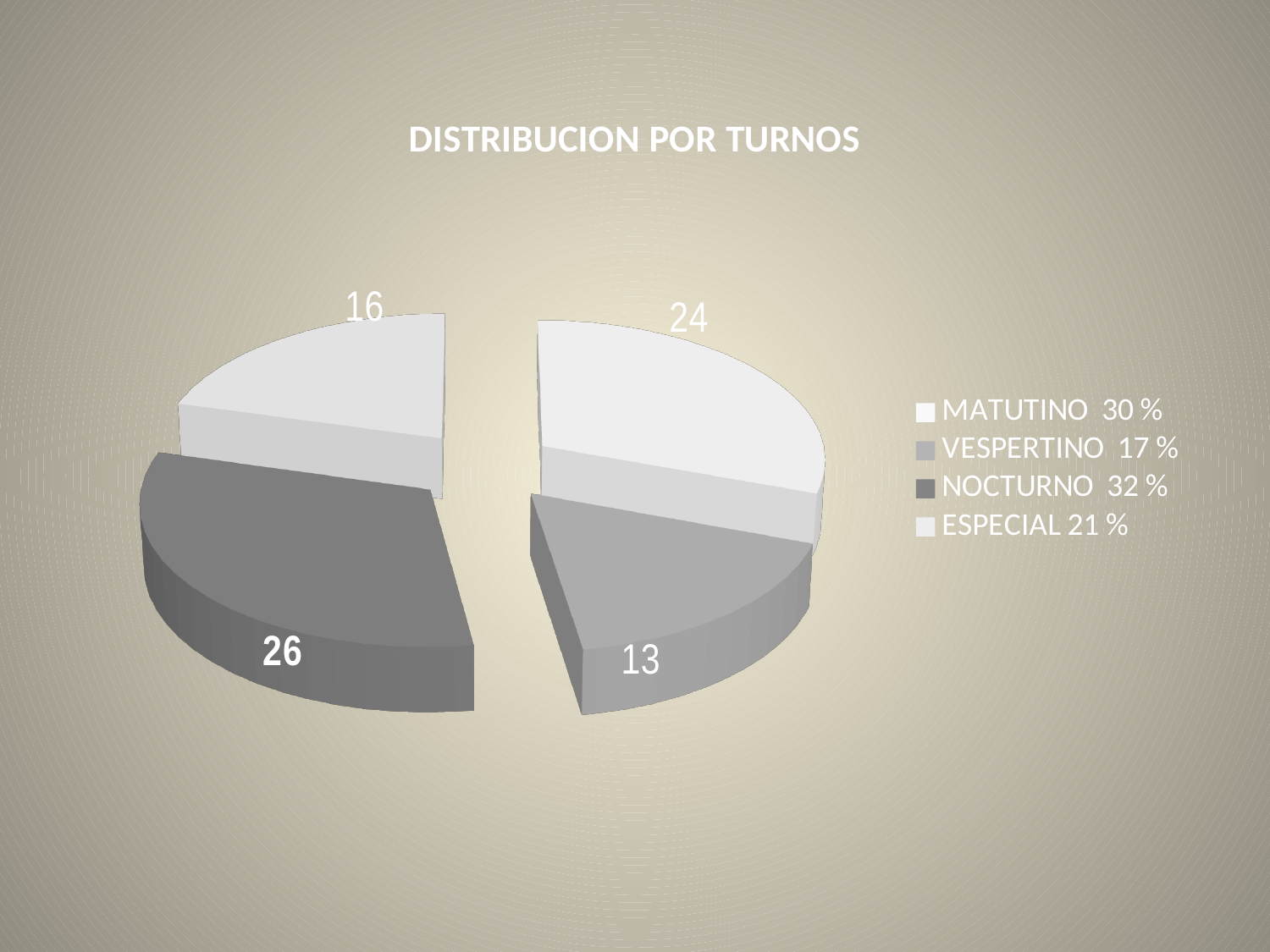
How many slices does the pie chart have? 4 What type of chart is shown on the slide? Pie chart What is the difference between the NOCTURNO and VESPERTINO values? 13 Which turno has the smallest slice? VESPERTINO What percentage share does the legend give for ESPECIAL? 21 % What is the value of the MATUTINO slice? 24 What is the value of the ESPECIAL slice? 16 What is the value of the NOCTURNO slice? 26 What is the total of all four slice values? 79 What is the value of the VESPERTINO slice? 13 What is the title of the chart? DISTRIBUCION POR TURNOS Which turno has the largest slice? NOCTURNO